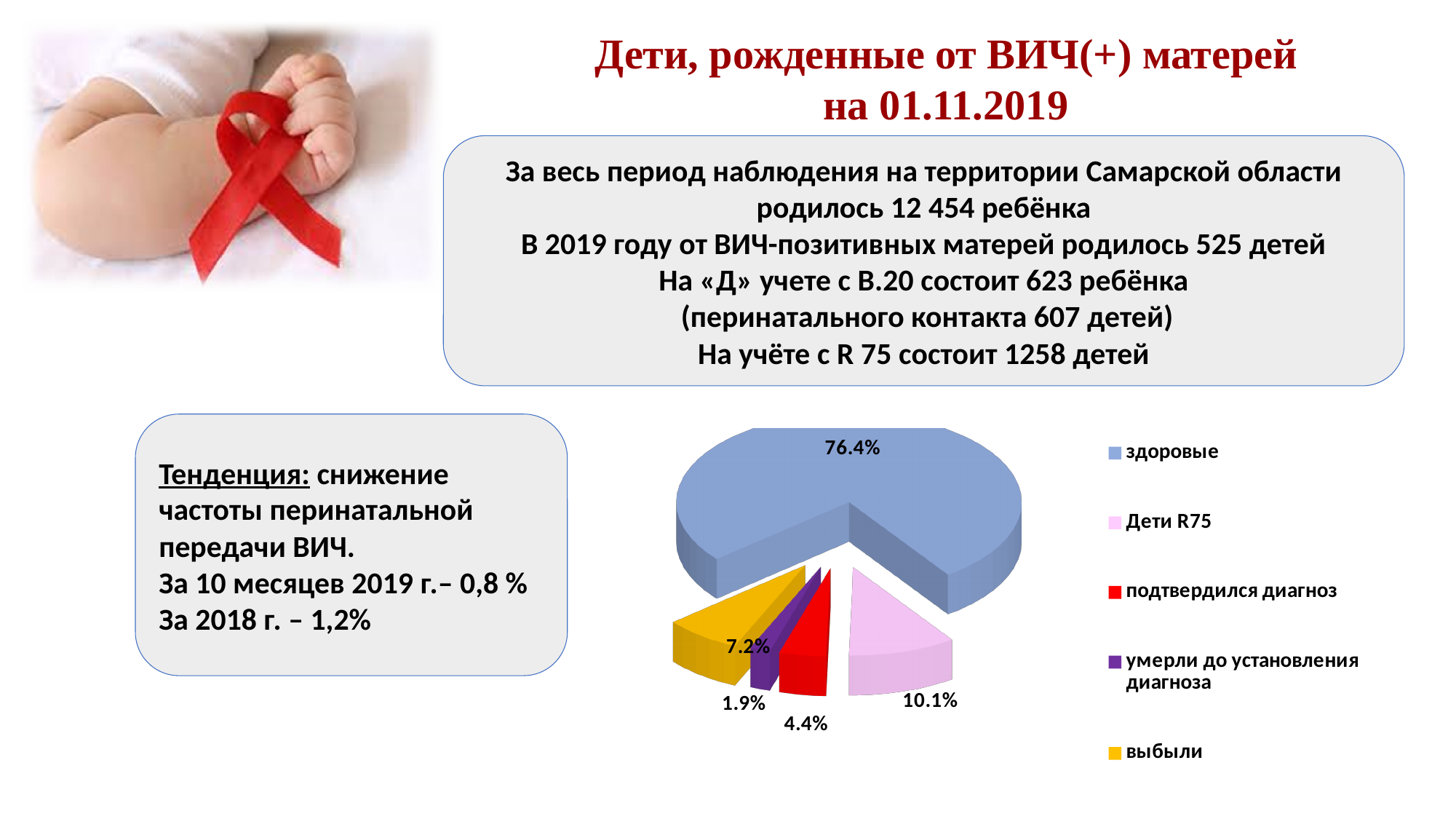
Which category has the largest slice in the pie chart? здоровые How many slices does the pie chart have? 5 What type of chart is shown on the slide? pie chart What percentage does the "Дети R75" slice show in the pie chart? 10.1% What is the difference between the "Дети R75" share and the "выбыли" share? 2.9% What percentage is shown for "умерли до установления диагноза"? 1.9% What share of the pie chart is labelled "здоровые"? 76.4% What is the value shown for "подтвердился диагноз" in the pie chart? 4.4% Which category has the smallest slice in the pie chart? умерли до установления диагноза What colour is the "здоровые" slice in the pie chart? blue Which is larger in the pie chart: "подтвердился диагноз" or "выбыли"? выбыли What is the value of the "выбыли" slice in the pie chart? 7.2%